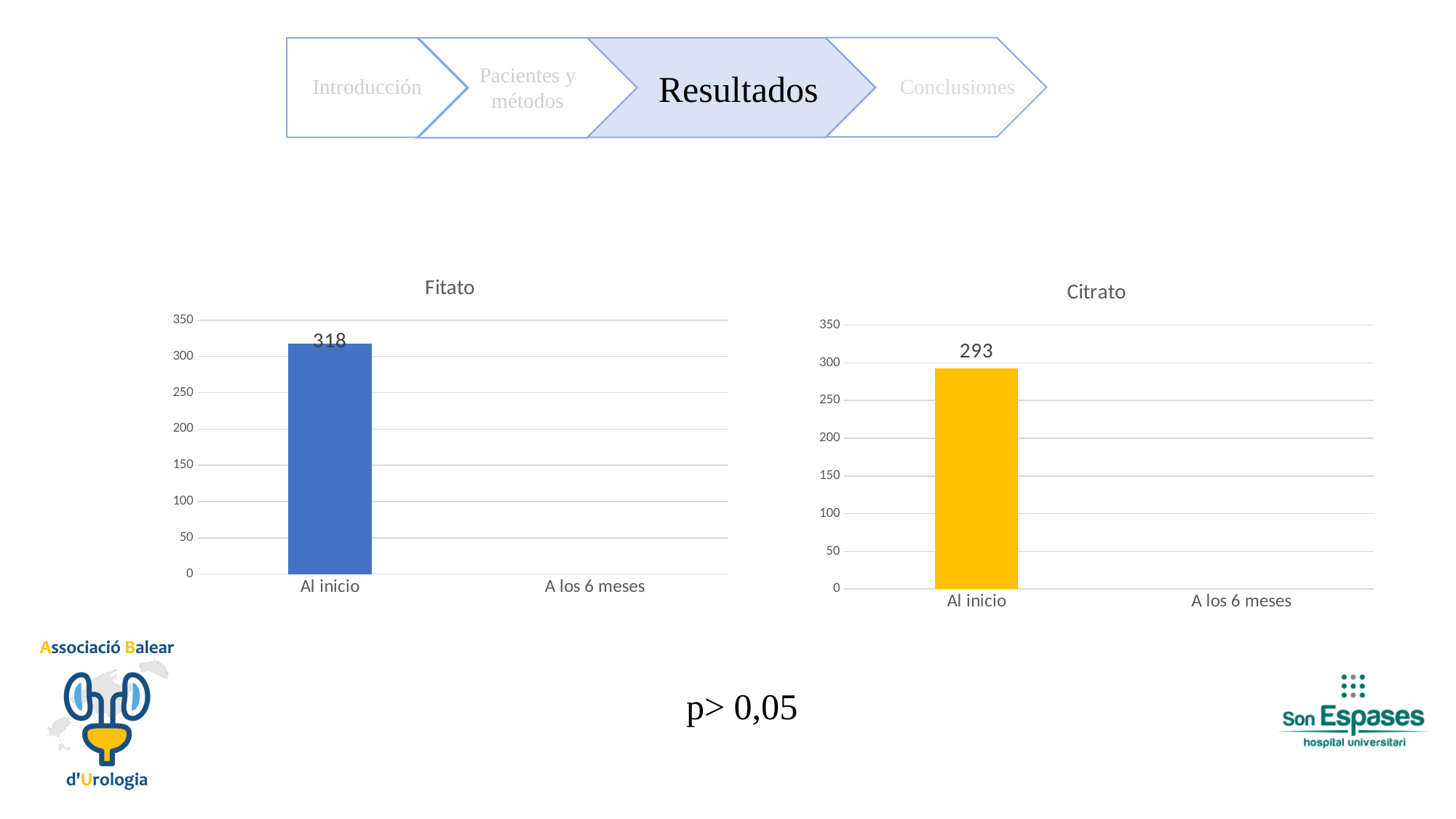
In the Citrato chart, what is the value for Al inicio? 293 How many categories are shown on the x axis of the Citrato chart? 2 What kind of chart is the Citrato chart? bar chart In the Fitato chart, is the value for Al inicio greater or less than 300? greater In the Citrato chart, is the value for Al inicio greater or less than 300? less How many categories are shown on the x axis of the Fitato chart? 2 What kind of chart is the Fitato chart? bar chart What is the title of the chart on the left of the slide? Fitato Which is larger: the Al inicio value in the Fitato chart or the Al inicio value in the Citrato chart? Fitato In the Fitato chart, what is the value for Al inicio? 318 What colour is the bar in the Citrato chart? yellow What is the difference between the Al inicio value in the Fitato chart and the Al inicio value in the Citrato chart? 25